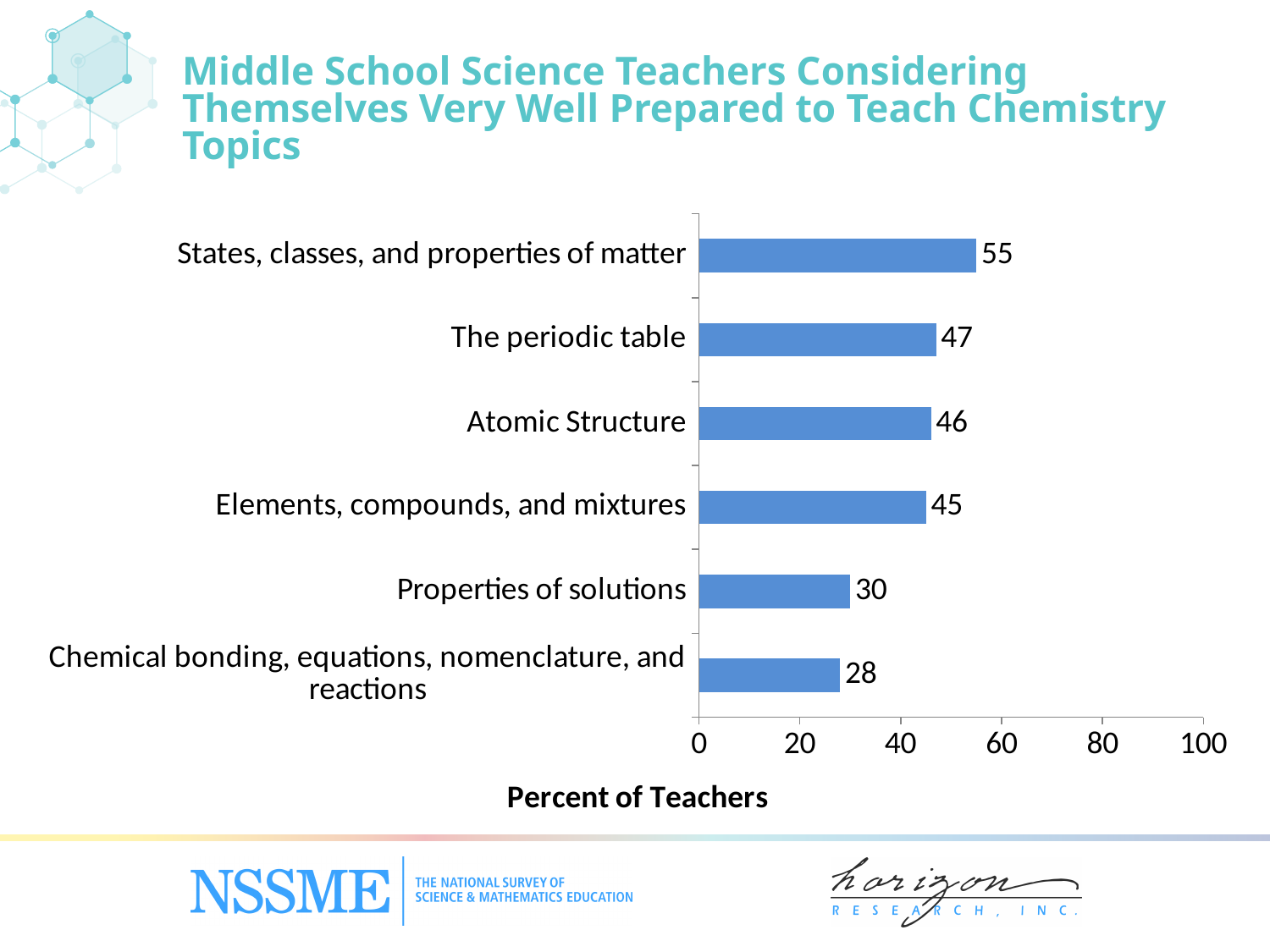
How many topics are shown in the chart? 6 What kind of chart is shown on the slide? Bar chart Which topic has the lowest percent of teachers? Chemical bonding, equations, nomenclature, and reactions What is the value for Properties of solutions? 30 Is the value for Elements, compounds, and mixtures greater or less than 40? greater Which topic has the highest percent of teachers? States, classes, and properties of matter What is the difference between the values for States, classes, and properties of matter and Chemical bonding, equations, nomenclature, and reactions? 27 What is the difference between the values for Atomic Structure and Properties of solutions? 16 What percent of teachers consider themselves very well prepared to teach states, classes, and properties of matter? 55 What is the value for Chemical bonding, equations, nomenclature, and reactions? 28 What is the value for The periodic table? 47 Which is larger, the value for The periodic table or the value for Properties of solutions? The periodic table